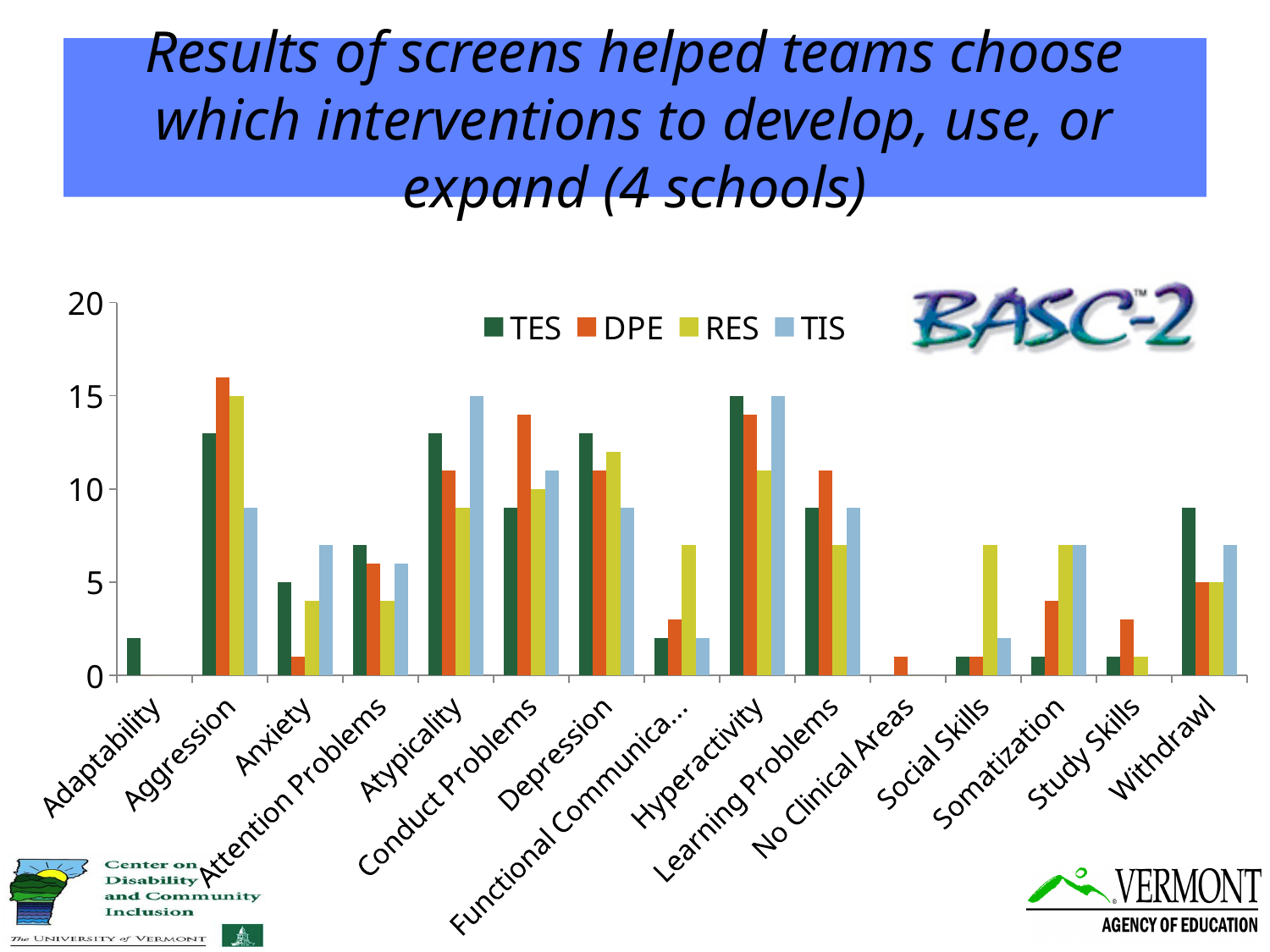
For Social Skills, which is larger: the RES value or the TIS value? RES Is the DPE value for Anxiety greater or less than 5? less What kind of chart is shown on the slide? bar chart For Aggression, which is larger: the DPE value or the TIS value? DPE Which series are listed in the legend? TES, DPE, RES, TIS Which series has the highest value for Aggression? DPE Which series has the highest value for Atypicality? TIS Is the DPE value for Aggression greater or less than 15? greater How many series does the legend list? 4 Which series has the highest value for Conduct Problems? DPE How many categories are shown along the x axis? 15 Is the TES value for Withdrawl greater or less than 10? less